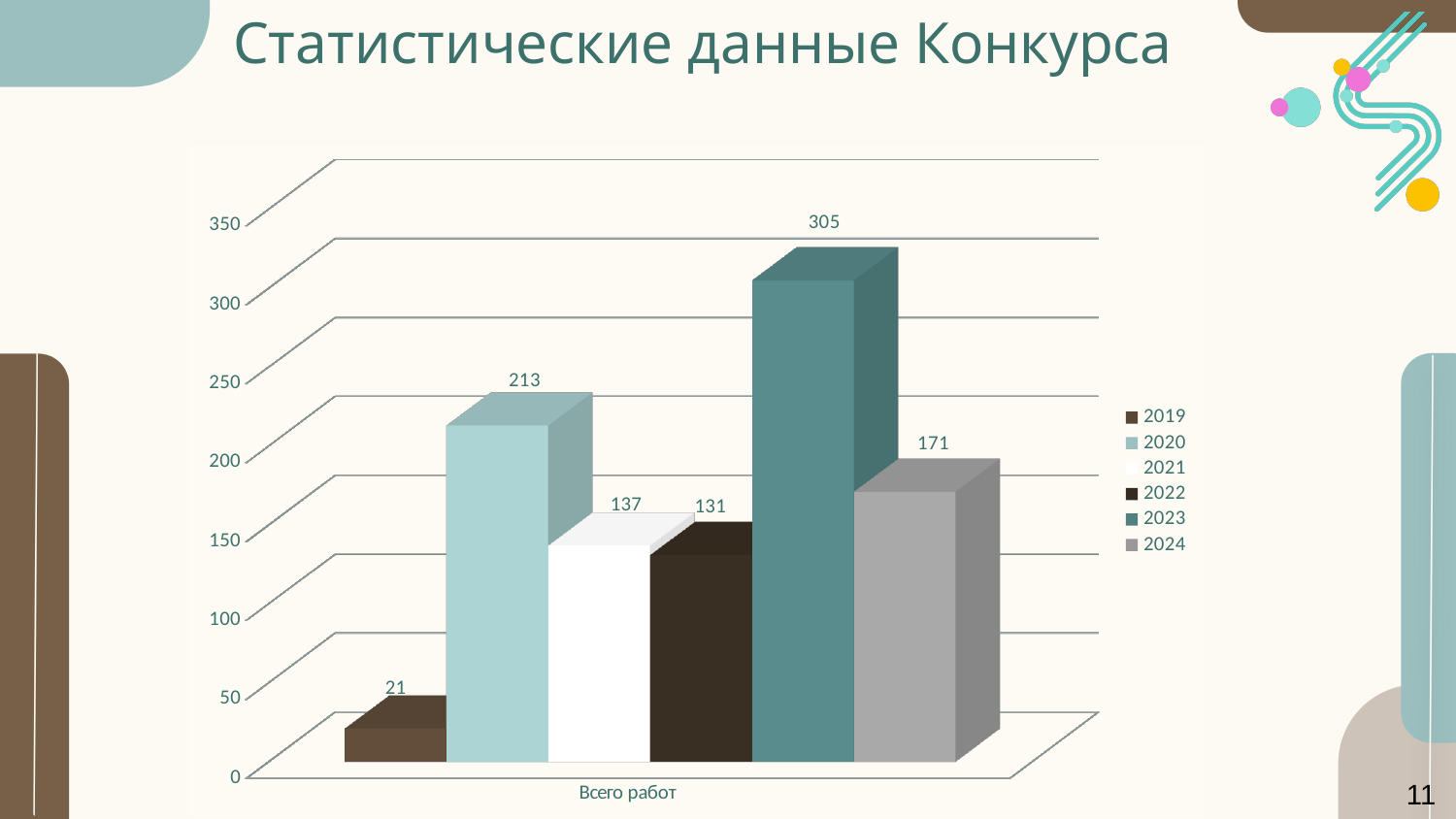
What is the difference between the values for 2021 and 2022? 6 Which year has the highest value in the chart? 2023 How many series does the legend list? 6 Which is larger, the value for 2020 or the value for 2024? 2020 What is the value for 2019 in the chart? 21 Which year has the lowest value in the chart? 2019 What is the value for 2021 in the chart? 137 What is the category label shown on the x axis of the chart? Всего работ What is the difference between the values for 2023 and 2020? 92 What is the value for 2023 in the chart? 305 What is the value for 2024 in the chart? 171 What kind of chart is shown on the slide? Bar chart